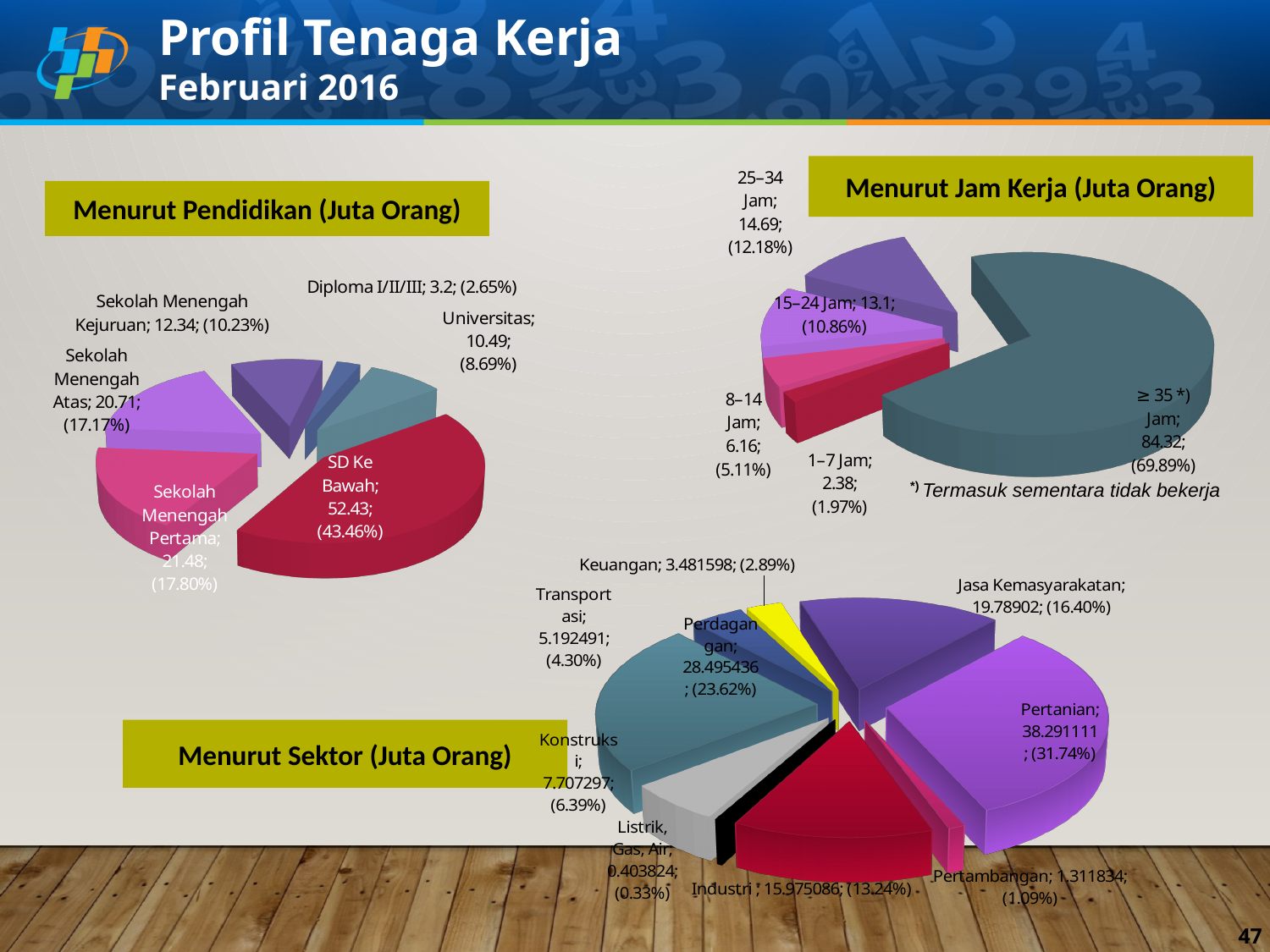
In the 'Menurut Jam Kerja (Juta Orang)' chart, which category has the highest value? ≥ 35 Jam In the 'Menurut Sektor (Juta Orang)' chart, how many sectors are shown? 9 In the 'Menurut Sektor (Juta Orang)' chart, which is larger, Industri or Perdagangan? Perdagangan In the 'Menurut Pendidikan (Juta Orang)' chart, which category has the lowest value? Diploma I/II/III In the 'Menurut Jam Kerja (Juta Orang)' chart, what share of the pie does 1–7 Jam hold? 1.97% In the 'Menurut Pendidikan (Juta Orang)' chart, how many categories are shown? 6 In the 'Menurut Pendidikan (Juta Orang)' chart, what is the value for SD Ke Bawah? 52.43 In the 'Menurut Sektor (Juta Orang)' chart, what is the value for Pertanian? 38.291111 In the 'Menurut Jam Kerja (Juta Orang)' chart, what is the value for 25–34 Jam? 14.69 In the 'Menurut Pendidikan (Juta Orang)' chart, what share of the pie does Universitas hold? 8.69% In the 'Menurut Jam Kerja (Juta Orang)' chart, what is the difference between the values for 15–24 Jam and 8–14 Jam? 6.94 What type of chart is used for 'Menurut Sektor (Juta Orang)'? Pie chart